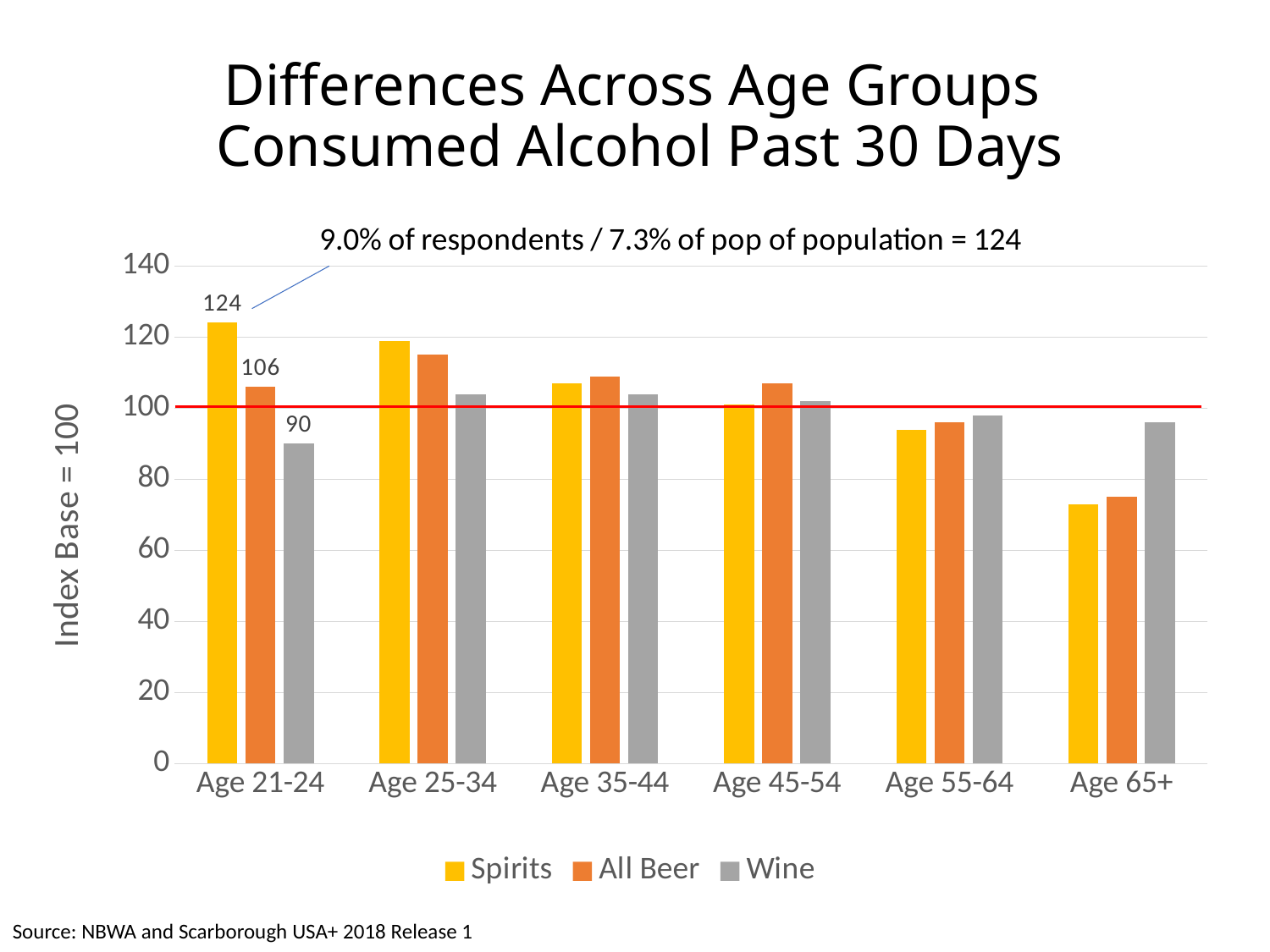
What is the Spirits value for Age 21-24? 124 What is the difference between the Spirits and Wine values for Age 21-24? 34 How many series does the legend list? 3 Which series has the lowest value in the Age 21-24 group? Wine How many age groups are shown on the x axis? 6 What is the Wine value for Age 21-24? 90 What is the All Beer value for Age 21-24? 106 Which series has the highest value in the Age 21-24 group? Spirits Is the Spirits value for Age 65+ greater or less than 80? less Do the Spirits values rise or fall as age increases along the x axis? fall Is the Spirits value for Age 25-34 greater or less than 100? greater In the Age 65+ group, which is larger, the Wine value or the Spirits value? Wine